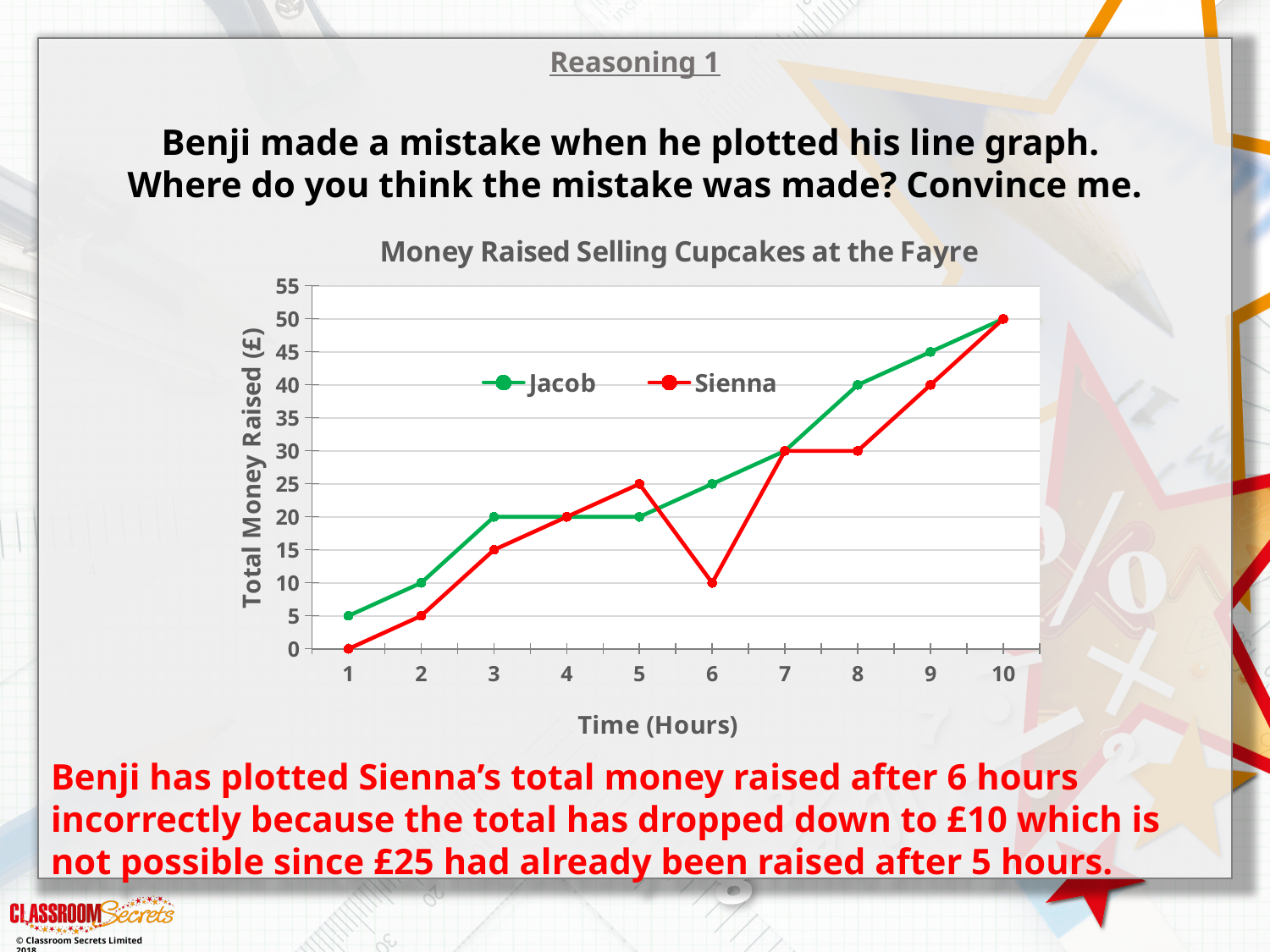
What is the label of the y axis? Total Money Raised (£) After 9 hours, who has raised more money, Jacob or Sienna? Jacob What is the total money raised by Sienna after 5 hours? £25 At which hour is Jacob's total money raised lowest? 1 What is the total money raised by Sienna after 6 hours? £10 How many time points are plotted along the x axis? 10 How many series does the legend list? 2 What is the difference between Jacob's and Sienna's totals after 6 hours? £15 What is the title of the chart? Money Raised Selling Cupcakes at the Fayre What kind of chart is shown on the slide? line chart Does Jacob's total money raised generally rise or fall over time? rise What is the total money raised by Jacob after 8 hours? £40